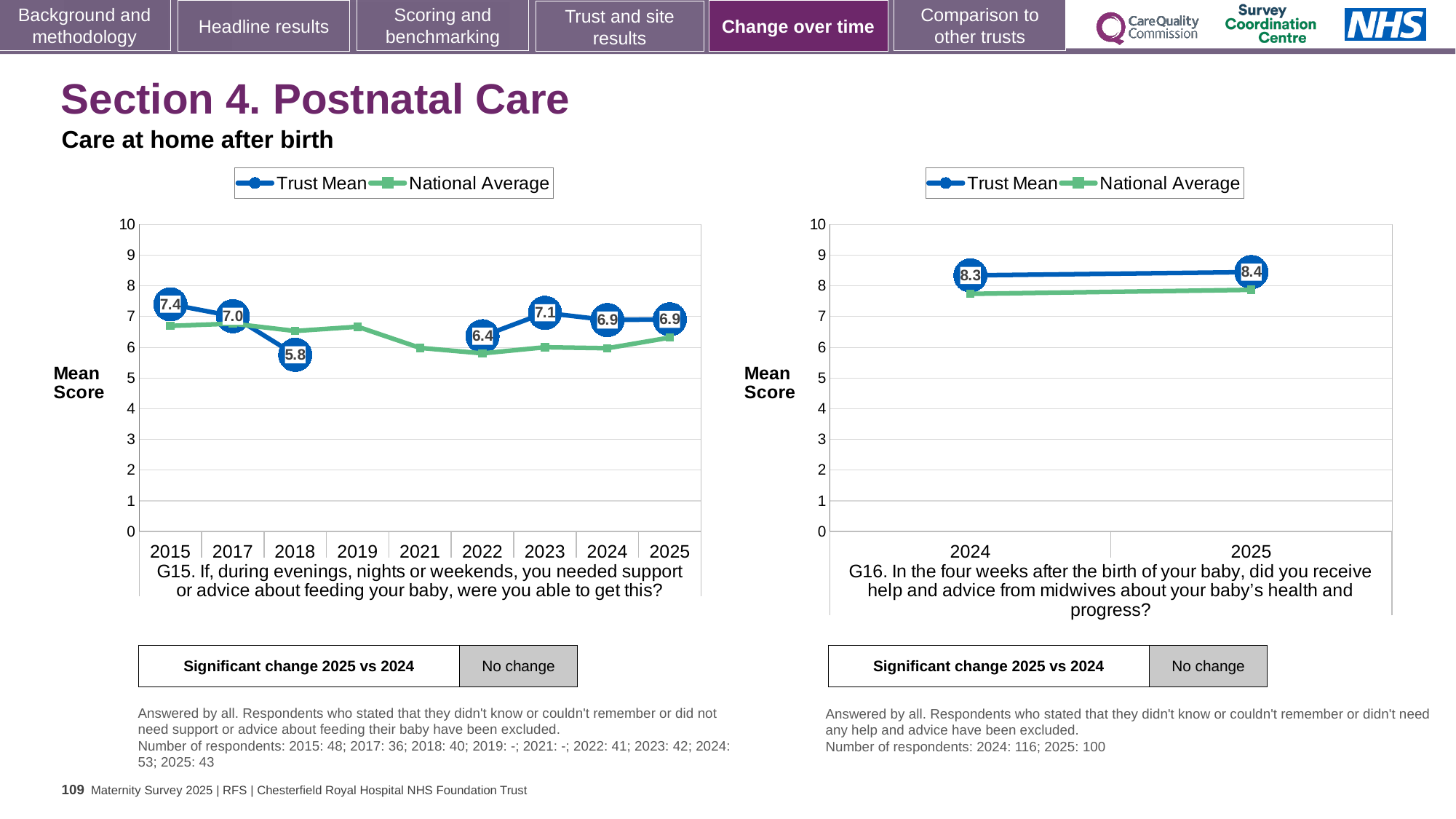
In the G15 chart on the left, which year has the lowest labelled Trust Mean? 2018 In the G16 chart on the right, what is the difference between the Trust Mean for 2025 and the Trust Mean for 2024? 0.1 In the G15 chart on the left, what is the difference between the Trust Mean for 2015 and the Trust Mean for 2018? 1.6 In the G15 chart on the left, what is the Trust Mean for 2023? 7.1 In the G16 chart on the right, what is the Trust Mean for 2025? 8.4 How many years are shown on the x axis of the G15 chart on the left? 9 How many series does the legend of the G16 chart on the right list? 2 In the G15 chart on the left, what is the Trust Mean for 2015? 7.4 In the G15 chart on the left, which year has the highest labelled Trust Mean? 2015 In the G15 chart on the left, what is the Trust Mean for 2018? 5.8 In the G15 chart on the left, is the National Average for 2022 greater or less than 6? less In the G16 chart on the right, is the National Average for 2024 greater or less than 7? greater